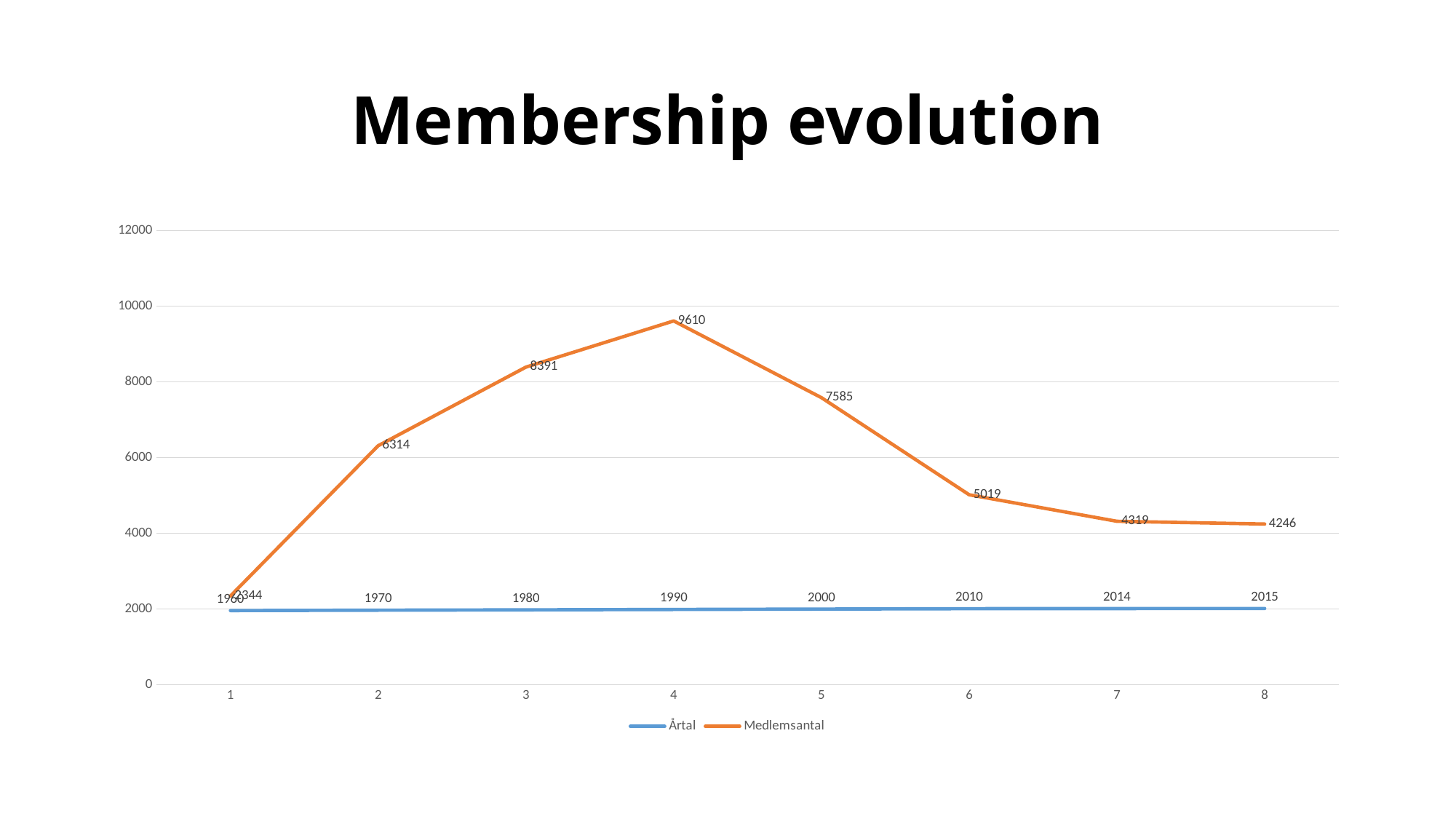
Which is larger, the Medlemsantal value at x-axis point 3 or at x-axis point 5? point 3 How many points are plotted along the x axis for the Medlemsantal series? 8 What type of chart is shown on the slide? line chart At which x-axis point is the Medlemsantal series highest? 4 At which x-axis point is the Medlemsantal series lowest? 1 How many series does the legend list? 2 What is the title of the chart? Membership evolution What is the Medlemsantal value at x-axis point 1? 2344 What is the difference between the Medlemsantal values at x-axis points 4 and 8? 5364 Does the Medlemsantal series rise or fall from x-axis point 4 to x-axis point 8? fall What is the Årtal value at x-axis point 7? 2014 What is the Medlemsantal value at x-axis point 4? 9610